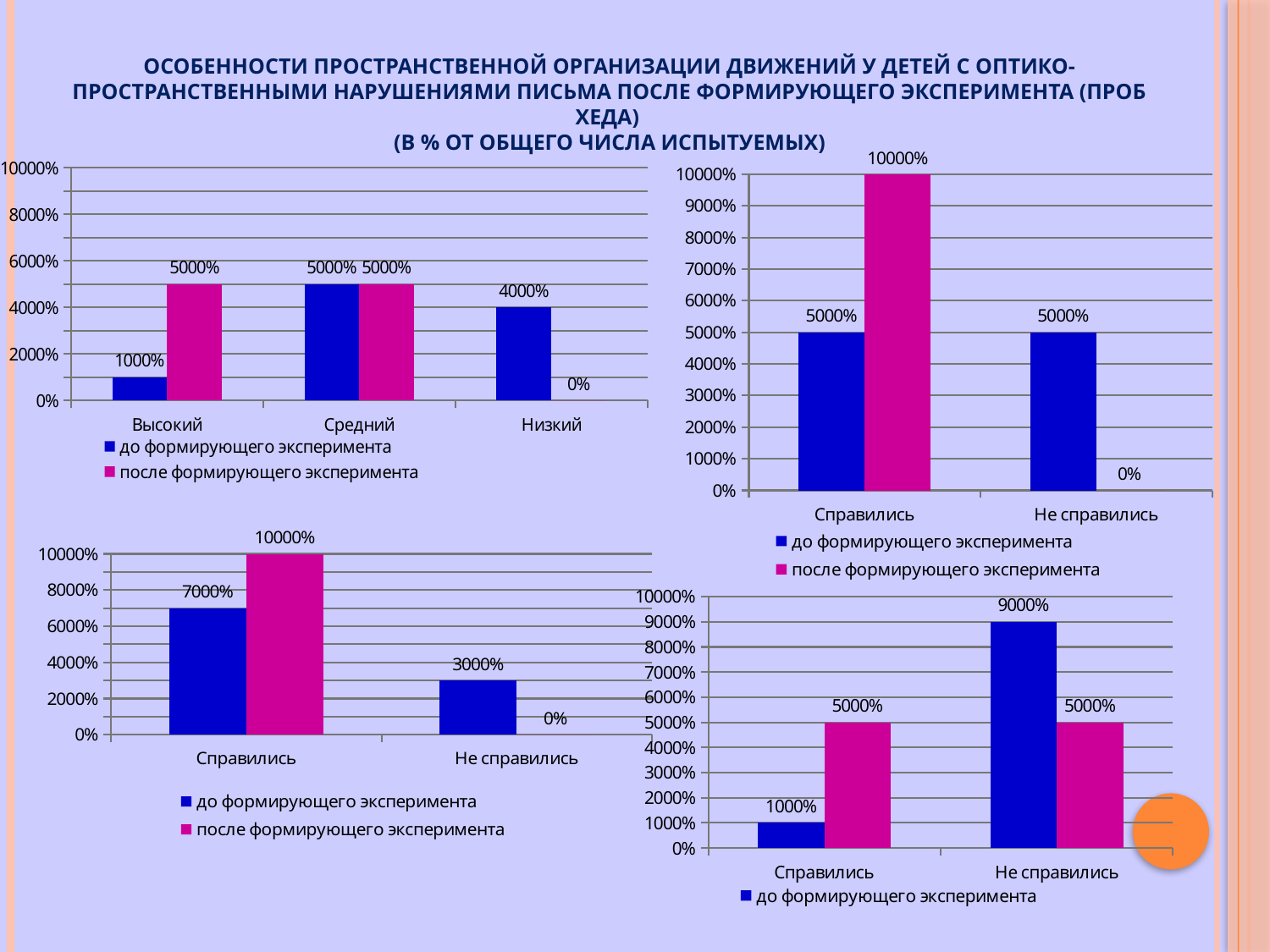
In the bottom-right chart, what is the value for Не справились in the series 'до формирующего эксперимента'? 9000% In the top-left chart, how many categories are shown on the x axis? 3 In the bottom-left chart, what is the difference between the 'до формирующего эксперимента' values for Справились and Не справились? 4000% In the top-right chart, what is the value for Справились in the series 'после формирующего эксперимента'? 10000% In the top-right chart, how many series does the legend list? 2 In the bottom-left chart, what is the value for Справились in the series 'до формирующего эксперимента'? 7000% In the bottom-right chart, which is larger for Справились: the blue bar or the magenta bar? the magenta bar In the top-left chart, what is the value for Низкий in the series 'после формирующего эксперимента'? 0% In the top-right chart, which category has the higher value in the series 'после формирующего эксперимента'? Справились In the top-left chart, what is the value for Высокий in the series 'до формирующего эксперимента'? 1000% What type of chart is the bottom-left chart? bar chart In the top-left chart, what is the difference between the 'после формирующего эксперимента' and 'до формирующего эксперимента' values for Высокий? 4000%